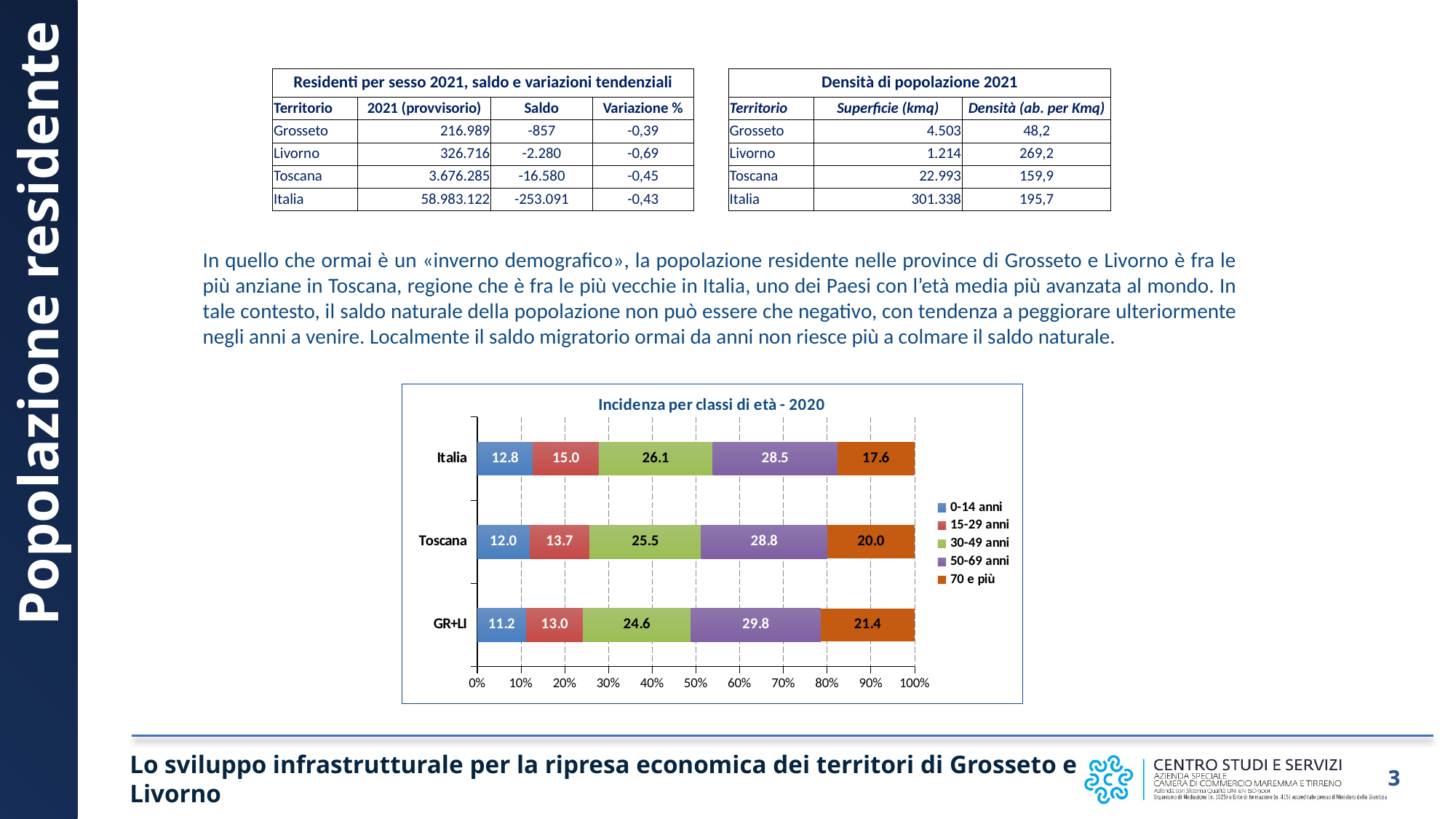
What is the difference between the 70 e più values for GR+LI and Italia? 3.8 What is the title of the chart? Incidenza per classi di età - 2020 What is the value for the 0-14 anni series for Italia? 12.8 What is the value for the 70 e più series for GR+LI? 21.4 What is the value for the 30-49 anni series for Toscana? 25.5 Which is larger, the 15-29 anni value for Italia or for Toscana? Italia What is the total of the stacked bar for Toscana? 100.0 What type of chart is shown on the slide? Stacked bar chart Which territory has the lowest value for the 0-14 anni series? GR+LI Which territory has the highest value for the 70 e più series? GR+LI How many series does the chart legend list? 5 How many territories (categories) are plotted in the chart? 3